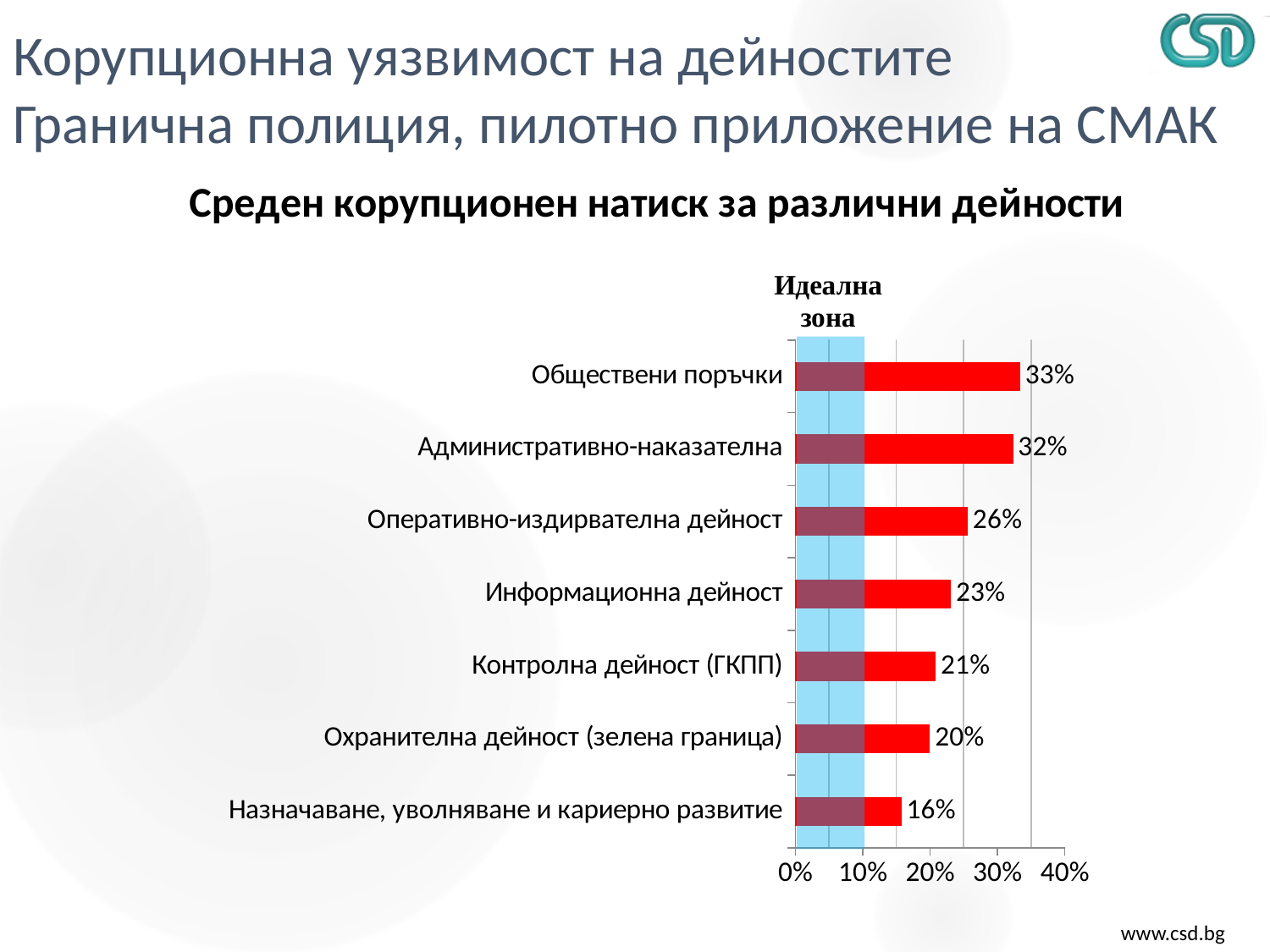
What is the title of the chart? Среден корупционен натиск за различни дейности Which category has the highest value? Обществени поръчки What is the difference between the values for Обществени поръчки and Назначаване, уволняване и кариерно развитие? 17% Is the value for Охранителна дейност (зелена граница) greater or less than 30%? less How many categories are shown in the chart? 7 What is the value for Назначаване, уволняване и кариерно развитие? 16% Which is larger, the value for Административно-наказателна or the value for Информационна дейност? Административно-наказателна What is the value for Обществени поръчки? 33% What is the value for Информационна дейност? 23% What is the difference between the values for Оперативно-издирвателна дейност and Контролна дейност (ГКПП)? 5% What kind of chart is shown on the slide? bar chart Which category has the lowest value? Назначаване, уволняване и кариерно развитие